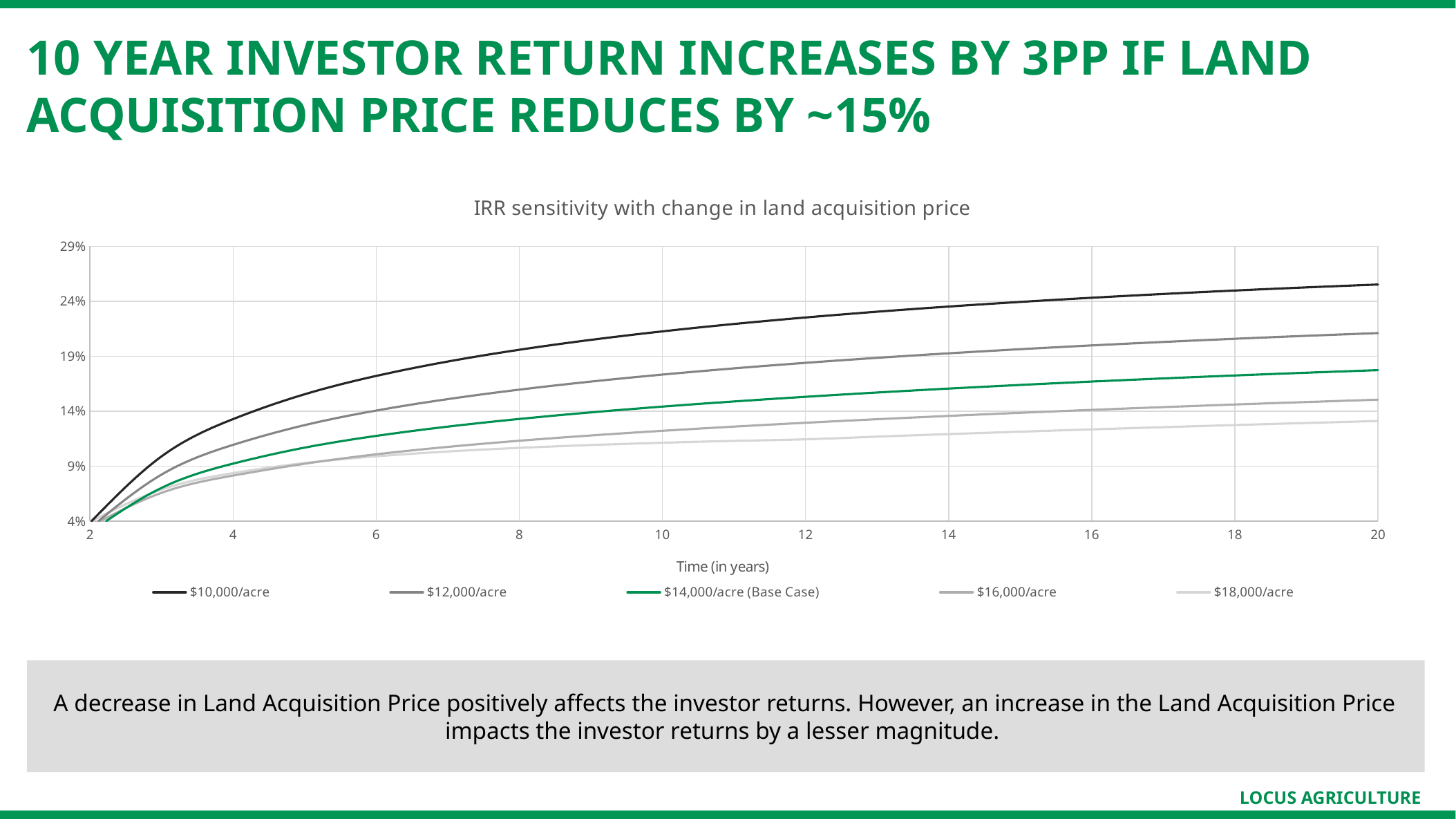
Is the value for $18,000/acre at year 20 greater or less than 14%? less What is the title of the chart? IRR sensitivity with change in land acquisition price Which series has the highest IRR at year 20? $10,000/acre At year 20, which is larger: the IRR for $10,000/acre or for $18,000/acre? $10,000/acre Is the value for $14,000/acre (Base Case) at year 20 greater or less than 19%? less How many series does the legend list? 5 What kind of chart is shown on the slide? Line chart Which series is plotted in green? $14,000/acre (Base Case) Which series has the lowest IRR at year 20? $18,000/acre Is the value for $10,000/acre at year 20 greater or less than 24%? greater Do the IRR values for the $14,000/acre (Base Case) series rise or fall as time increases? Rise